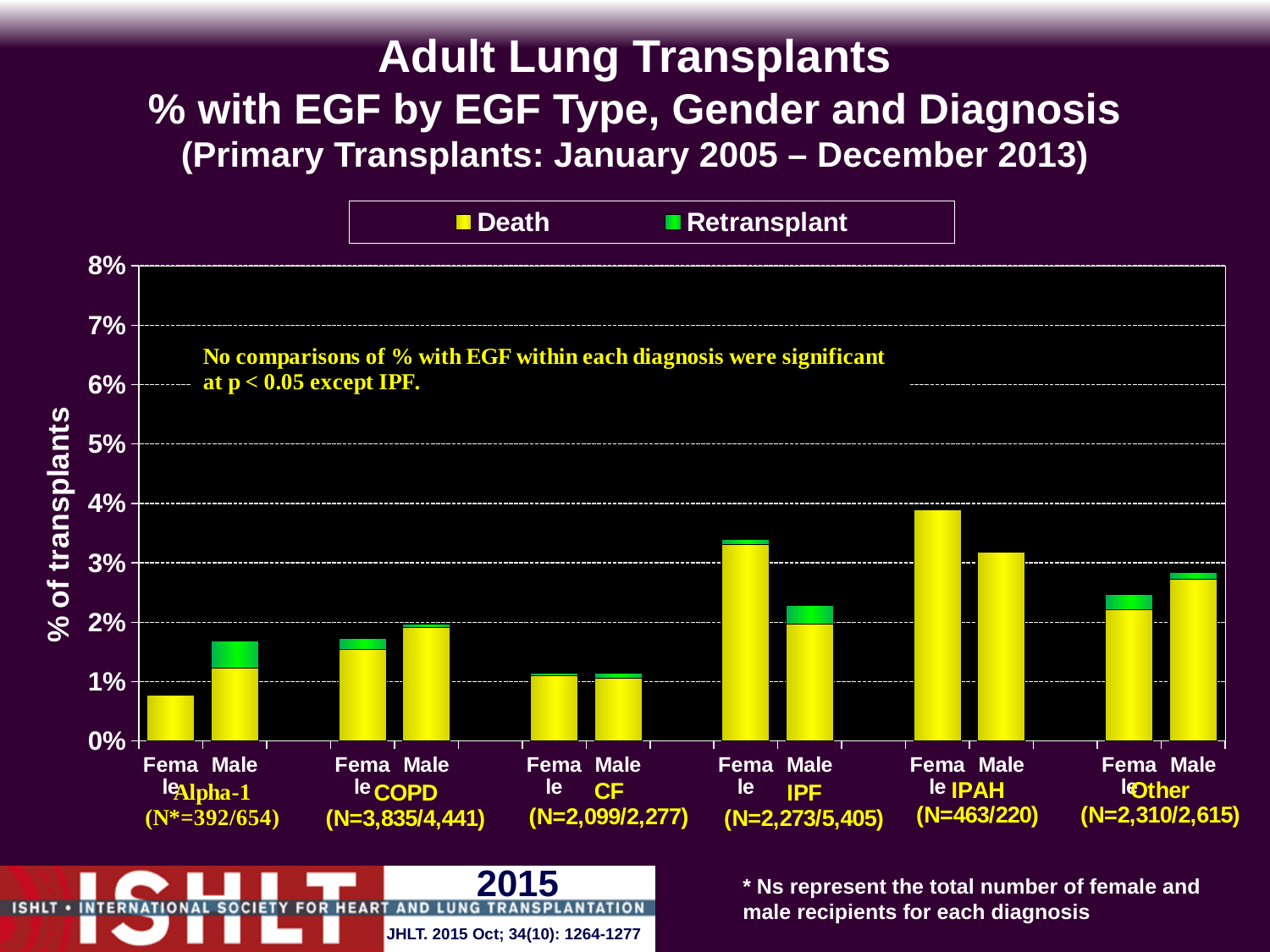
Is the total value for Alpha-1 Female greater or less than 1%? less Within the IPF diagnosis, which gender has the larger total % with EGF? Female Which bar is the lowest on the chart? Alpha-1 Female Is the total value for IPAH Female greater or less than 3%? greater What kind of chart is shown on the slide? bar chart Which diagnosis group has the highest total % with EGF for female recipients? IPAH Which colour represents the Death series in the legend? yellow Is the total value for IPF Male greater or less than 2%? greater Within the Alpha-1 diagnosis, which gender has the larger total % with EGF? Male How many series does the legend list? 2 How many diagnosis groups are shown along the x axis? 6